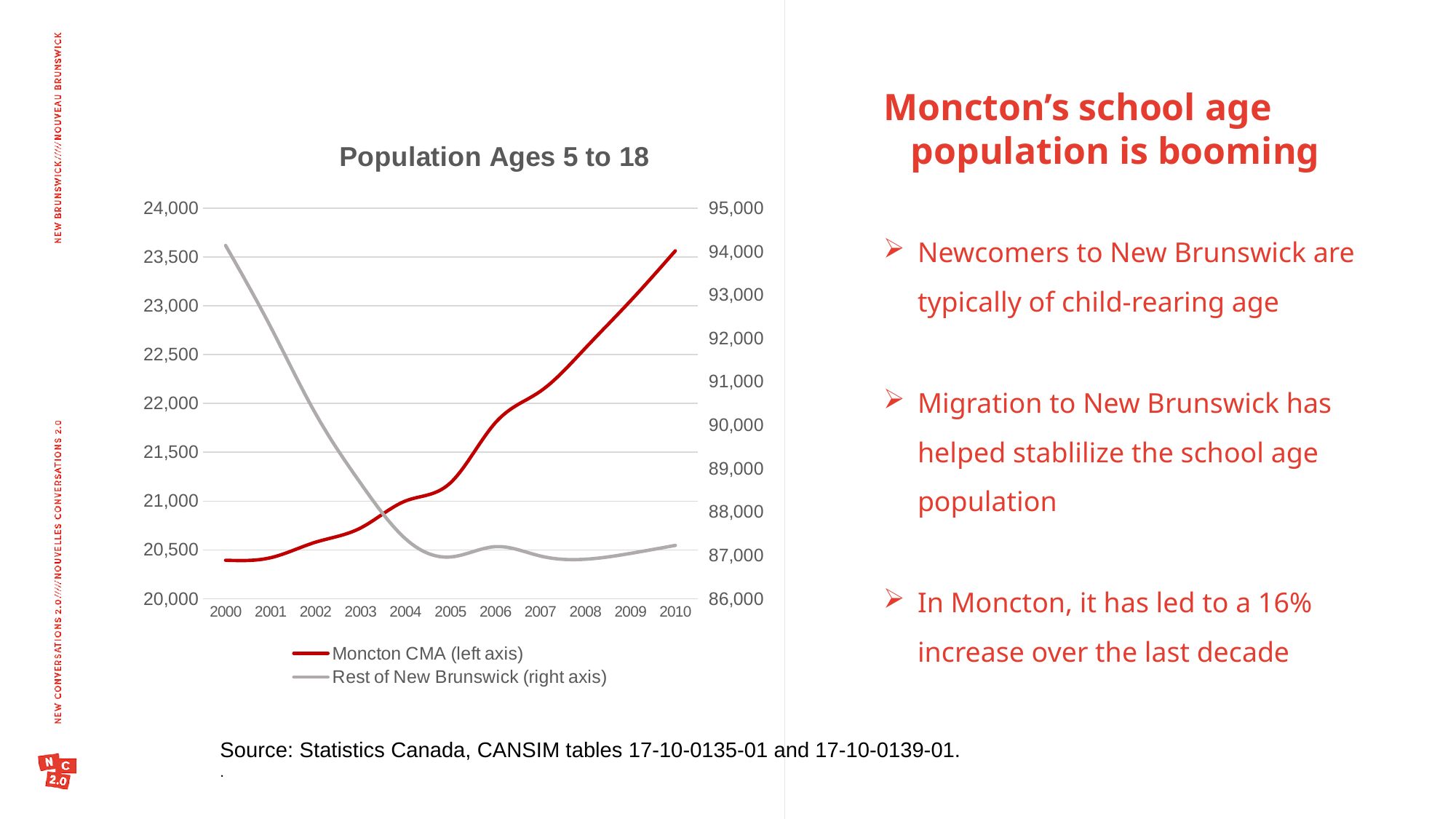
Is the Moncton CMA value for 2010 greater or less than 23,000? greater How many years are plotted along the x axis of the chart? 11 What type of chart is shown on the slide? line chart What is the title of the chart? Population Ages 5 to 18 How many series does the chart's legend list? 2 Is the Rest of New Brunswick value for 2010 greater or less than 88,000? less Which series is plotted against the right axis? Rest of New Brunswick Does the Moncton CMA series rise or fall from 2000 to 2010? rise Is the Moncton CMA value for 2000 greater or less than 20,500? less In which year is the Moncton CMA value highest? 2010 Does the Rest of New Brunswick series rise or fall overall from 2000 to 2010? fall In which year is the Rest of New Brunswick value highest? 2000